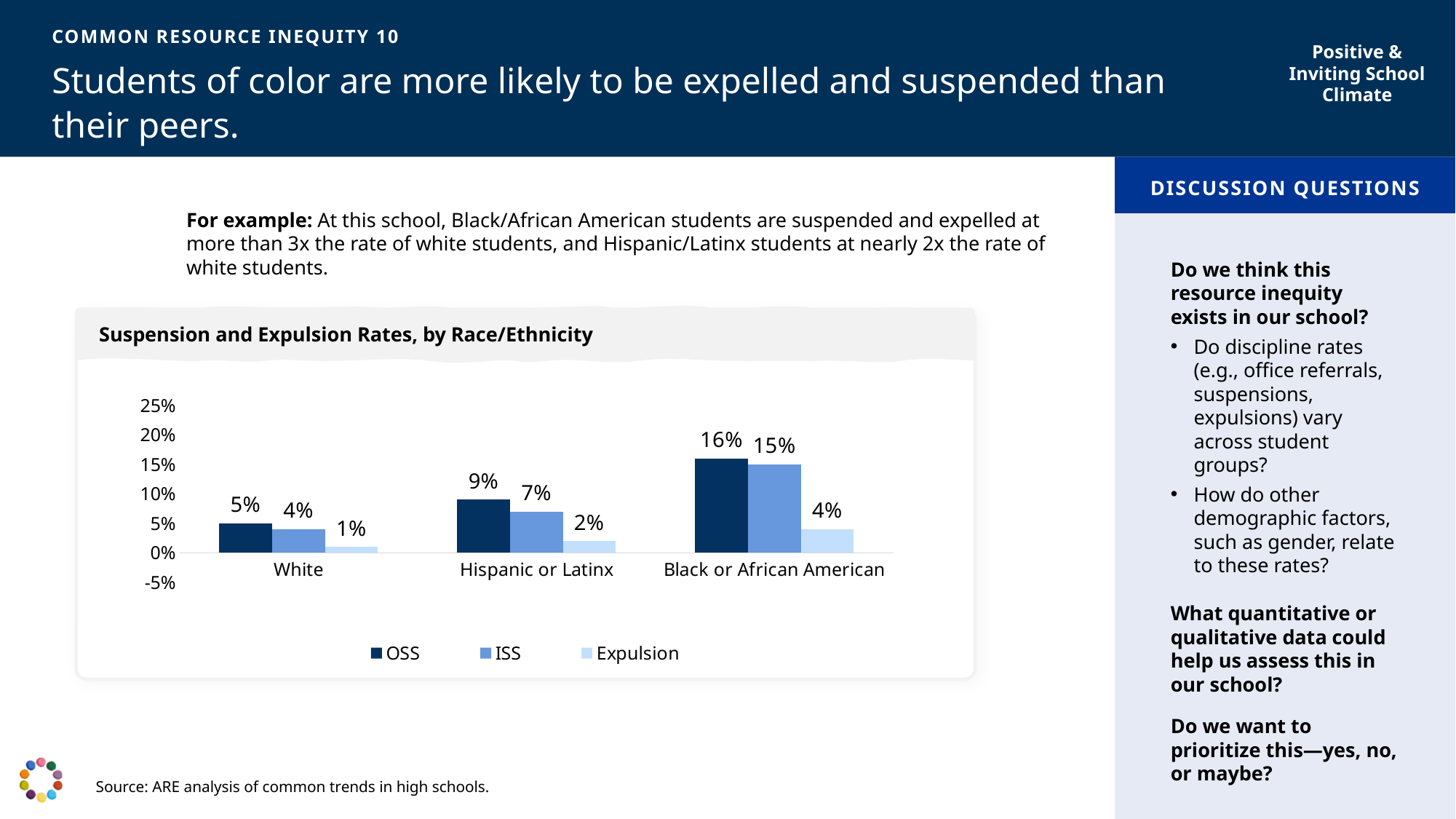
What is the ISS rate for Hispanic or Latinx students? 7% What is the title of the chart? Suspension and Expulsion Rates, by Race/Ethnicity Which race/ethnicity group has the highest OSS rate? Black or African American What kind of chart is shown on the slide? Bar chart What is the Expulsion rate for White students? 1% How many series does the legend list? 3 How many race/ethnicity categories are shown on the x axis? 3 What is the difference between the OSS rate for Black or African American students and the OSS rate for White students? 11% Which is larger: the ISS rate for Hispanic or Latinx students or the ISS rate for White students? Hispanic or Latinx Which race/ethnicity group has the lowest Expulsion rate? White What is the OSS rate for Black or African American students? 16% Is the ISS rate for Black or African American students greater or less than 10%? greater